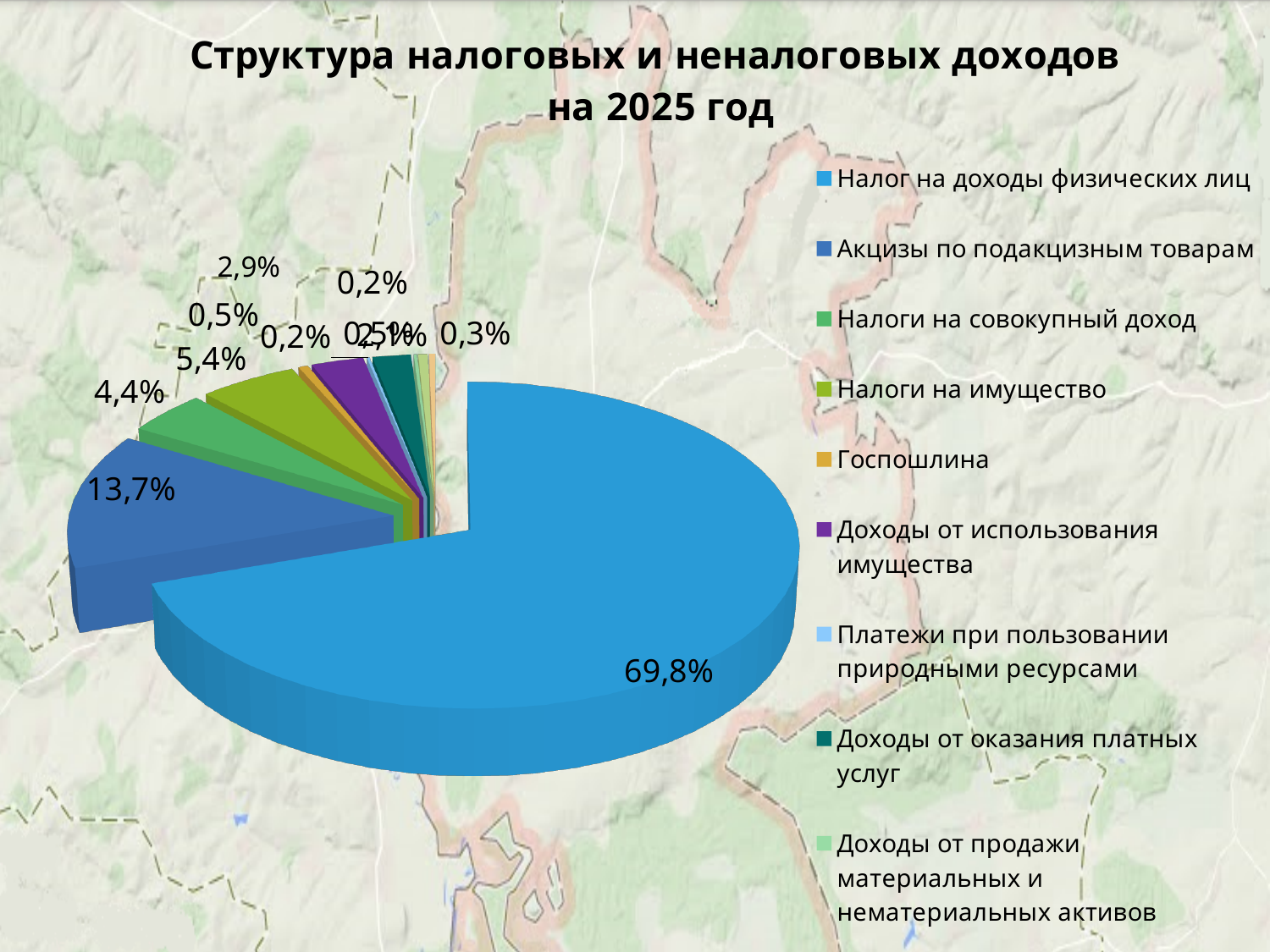
Which is larger: "Налоги на имущество" or "Налоги на совокупный доход"? Налоги на имущество What kind of chart is shown on the slide? Pie chart What is the value for "Акцизы по подакцизным товарам"? 13,7% Which category has the largest share of the pie? Налог на доходы физических лиц What is the value for "Налоги на совокупный доход"? 4,4% What is the title of the chart? Структура налоговых и неналоговых доходов на 2025 год What is the value for "Доходы от использования имущества"? 2,9% What is the value for "Налоги на имущество"? 5,4% What is the difference between the shares of "Налоги на имущество" and "Налоги на совокупный доход"? 1,0% What is the difference between the shares of "Налог на доходы физических лиц" and "Акцизы по подакцизным товарам"? 56,1% How many entries does the legend list? 9 What share of the pie does "Налог на доходы физических лиц" have? 69,8%